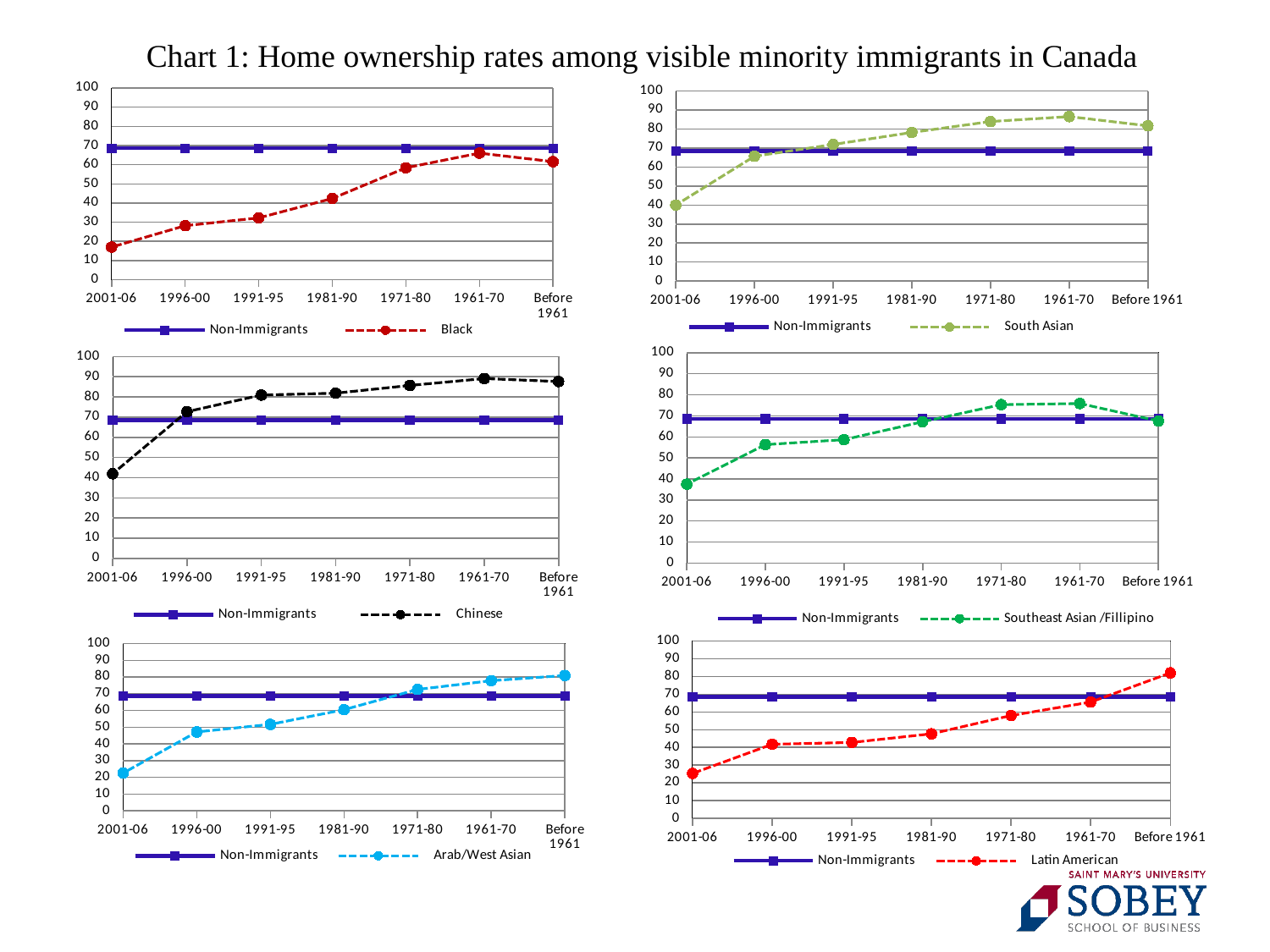
In the bottom-left chart, which is larger for Arab/West Asian: the value for 2001-06 or the value for 1996-00? 1996-00 In the top-left chart, is the Black value for 2001-06 greater or less than 20? less In the bottom-right chart, does the Latin American line rise or fall from 2001-06 to Before 1961? rises In the top-right chart, is the South Asian value for 1961-70 greater or less than 80? greater What kind of chart is the top-left chart (Non-Immigrants vs Black)? line chart In the middle-left chart, is the Chinese value for 1961-70 greater or less than 80? greater In the bottom-right chart, which period has the highest Latin American home ownership rate? Before 1961 In the top-right chart (South Asian), how many series does the legend list? 2 In the middle-left chart, which period has the lowest Chinese home ownership rate? 2001-06 What is the title shown above the charts on the slide? Chart 1: Home ownership rates among visible minority immigrants in Canada In the top-left chart (Black), how many time-period categories are shown on the x axis? 7